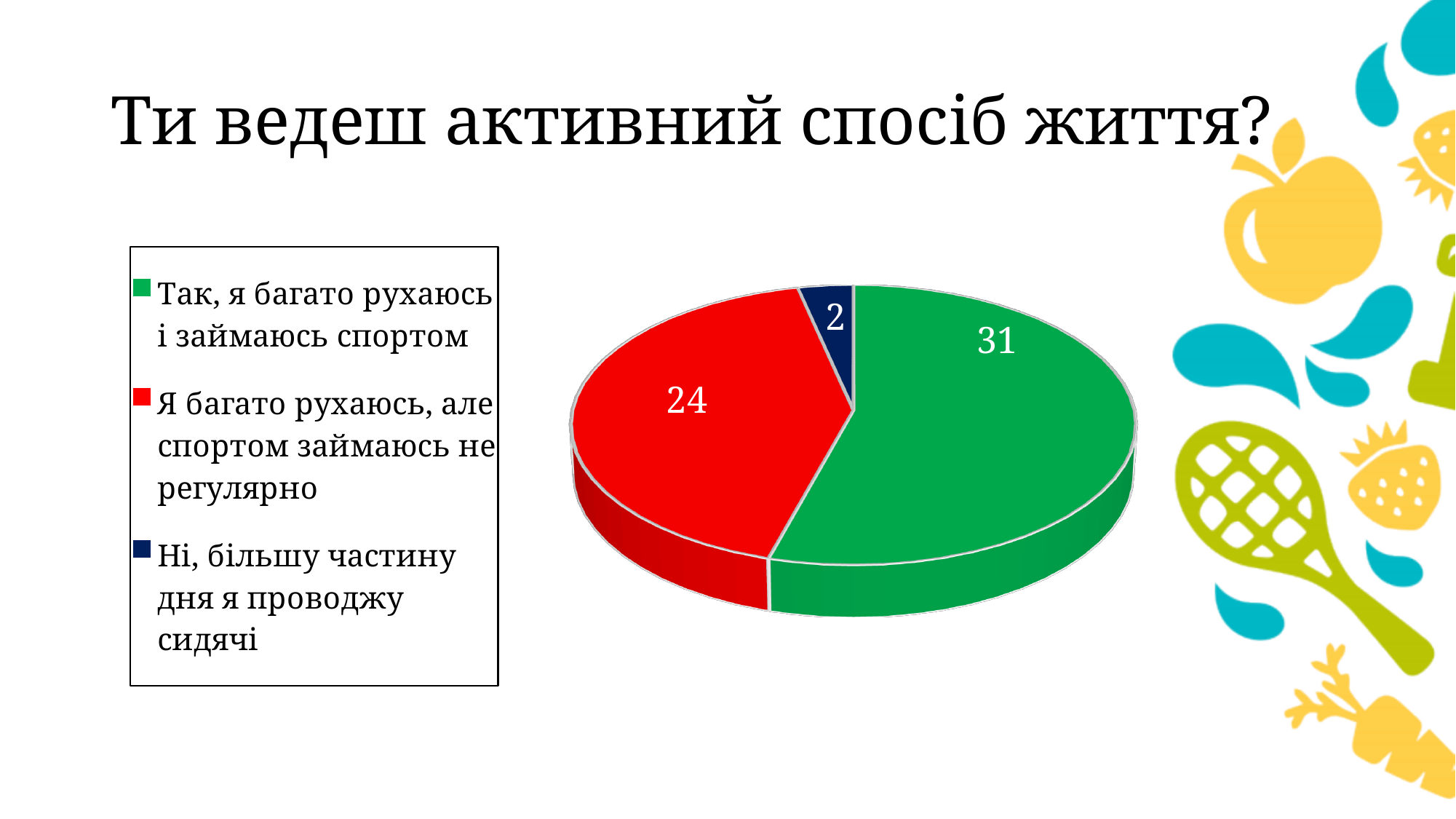
What colour is the slice for "Ні, більшу частину дня я проводжу сидячі"? dark blue Which category has the smallest slice of the pie? Ні, більшу частину дня я проводжу сидячі What is the value for "Ні, більшу частину дня я проводжу сидячі"? 2 What is the total of all the slices in the pie chart? 57 How many categories does the pie chart have? 3 What is the title of the slide containing the pie chart? Ти ведеш активний спосіб життя? Which is larger: the value for "Я багато рухаюсь, але спортом займаюсь не регулярно" or the value for "Ні, більшу частину дня я проводжу сидячі"? Я багато рухаюсь, але спортом займаюсь не регулярно What is the difference between the values for "Так, я багато рухаюсь і займаюсь спортом" and "Я багато рухаюсь, але спортом займаюсь не регулярно"? 7 What kind of chart is shown on the slide? pie chart What is the value for "Я багато рухаюсь, але спортом займаюсь не регулярно"? 24 Which category has the largest slice of the pie? Так, я багато рухаюсь і займаюсь спортом What is the value for "Так, я багато рухаюсь і займаюсь спортом"? 31